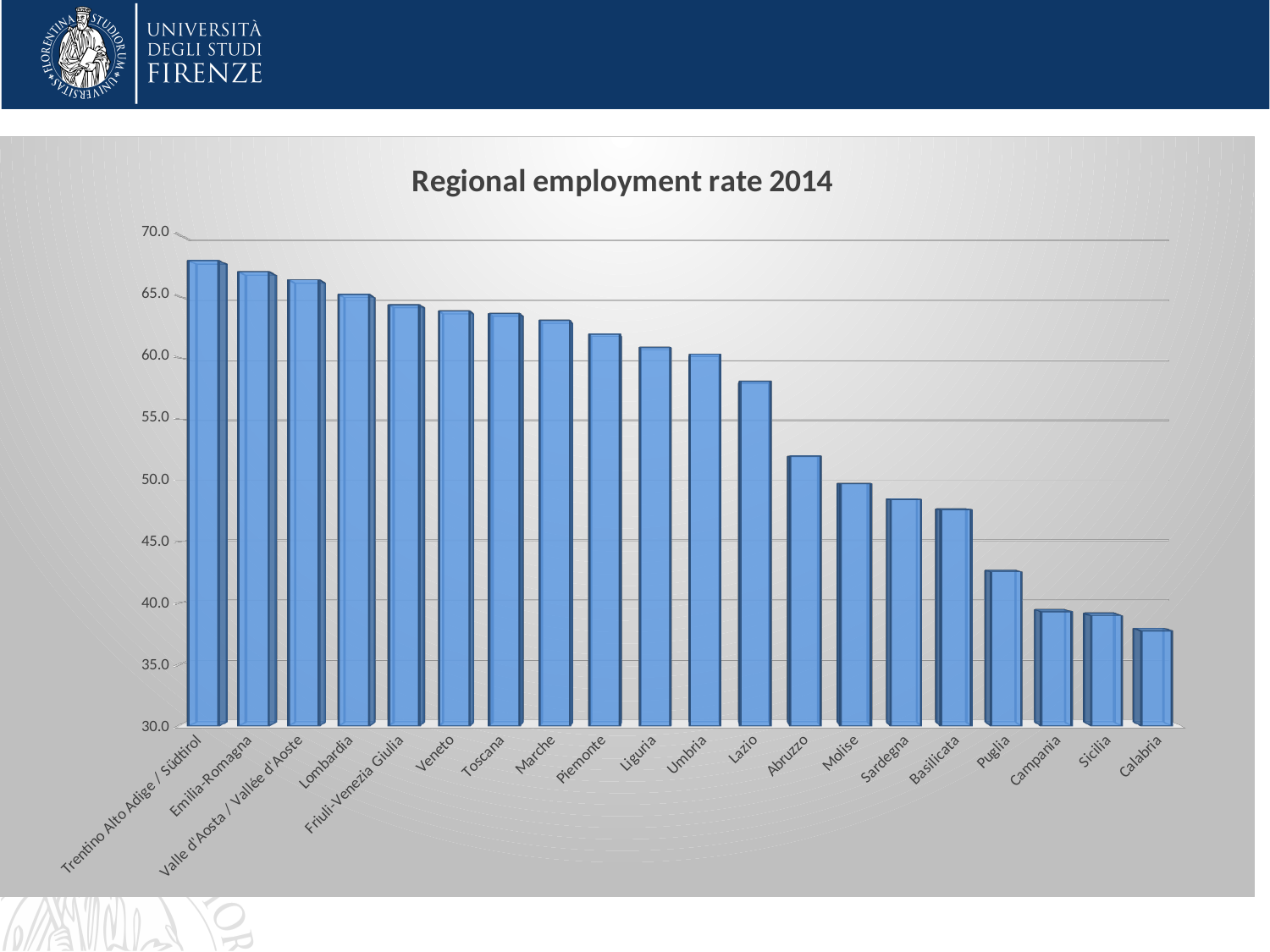
What is the title of the chart? Regional employment rate 2014 Do the values rise or fall moving from left to right along the x axis? Fall Which region has the highest employment rate in the chart? Trentino Alto Adige / Südtirol How many regions are shown on the x axis of the chart? 20 Is the value for Lazio greater or less than 55.0? greater Which has the larger value, Lazio or Abruzzo? Lazio What type of chart is shown on the slide? Bar chart Which has the larger value, Puglia or Campania? Puglia Is the value for Veneto greater or less than 60.0? greater Which region has the lowest employment rate in the chart? Calabria Is the value for Calabria greater or less than 40.0? less